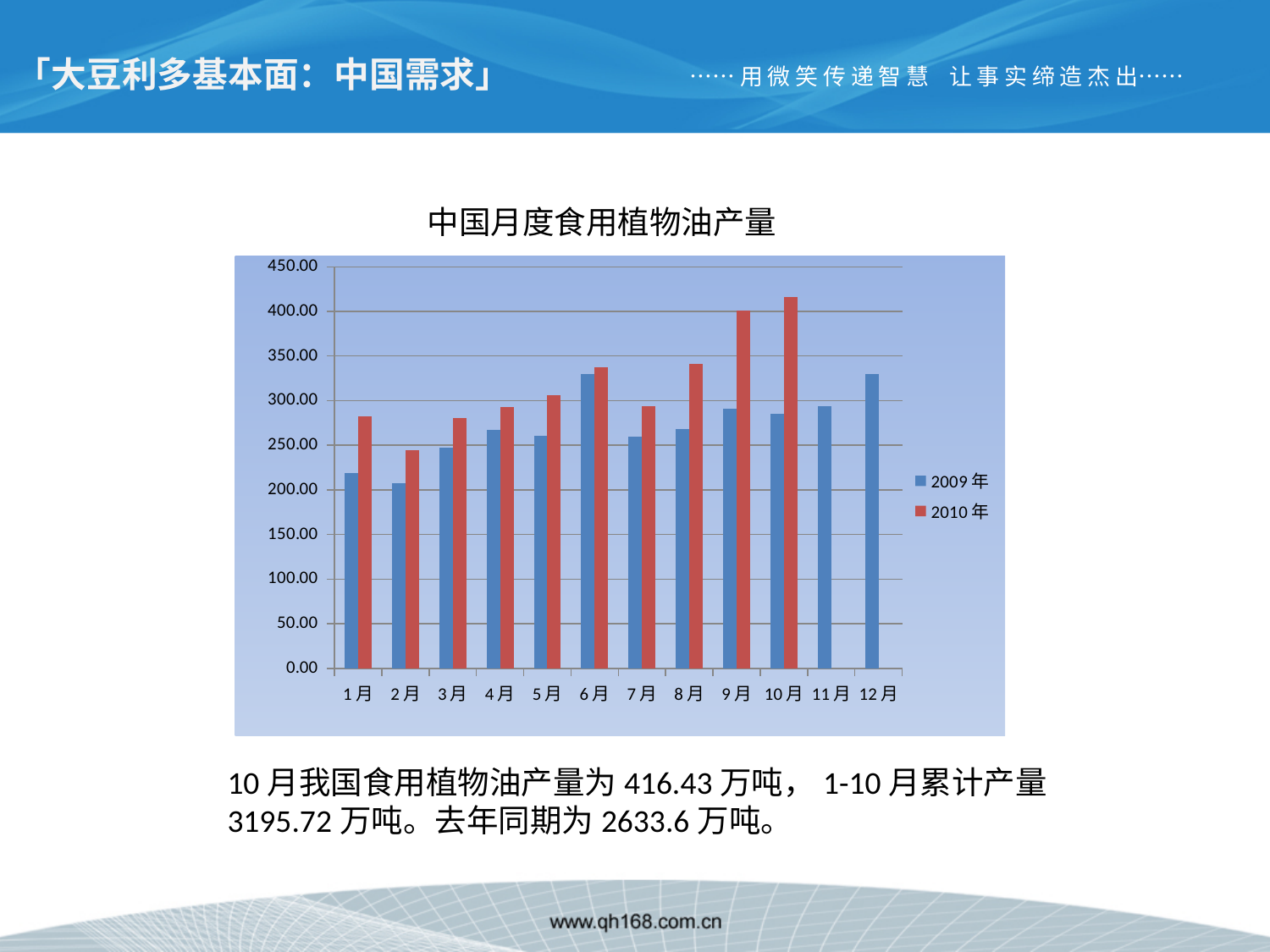
Which months have no bar for the 2010年 series? 11月 and 12月 Is the 2010年 value for 10月 greater or less than 400? greater Is the 2009年 value for 1月 greater or less than 250? less How many months are shown on the x axis? 12 Does the 2010年 series generally rise or fall from 1月 to 10月? rise What kind of chart is shown on the slide? bar chart Which month has the highest value for the 2010年 series? 10月 For 10月, which series has the larger value, 2009年 or 2010年? 2010年 Is the 2010年 value for 1月 greater or less than 250? greater What is the title of the chart? 中国月度食用植物油产量 How many series does the legend list? 2